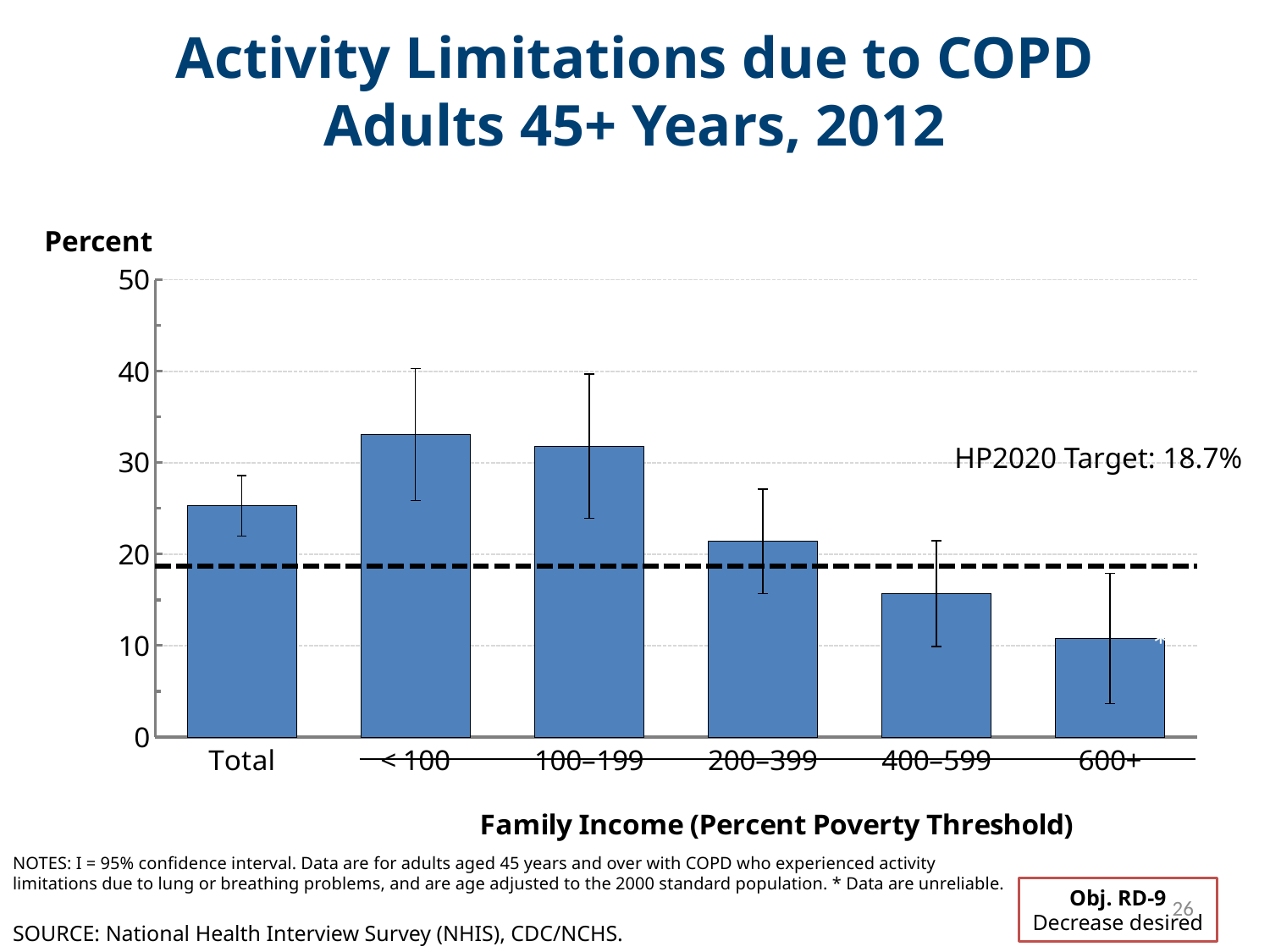
Which is larger, the value for Total or the value for 400-599? Total Is the value for the 600+ category greater or less than 20? less Which family income category has the lowest percentage of activity limitations? 600+ What is the HP2020 Target value shown on the chart? 18.7% What kind of chart is shown on the slide? bar chart Is the value for the 200-399 category greater or less than 30? less Is the value for the Total bar greater or less than 20? greater Moving from the <100 category to the 600+ category, do the values rise or fall? fall Which is larger, the value for <100 or the value for 600+? <100 How many family income categories (bars) are shown on the chart? 6